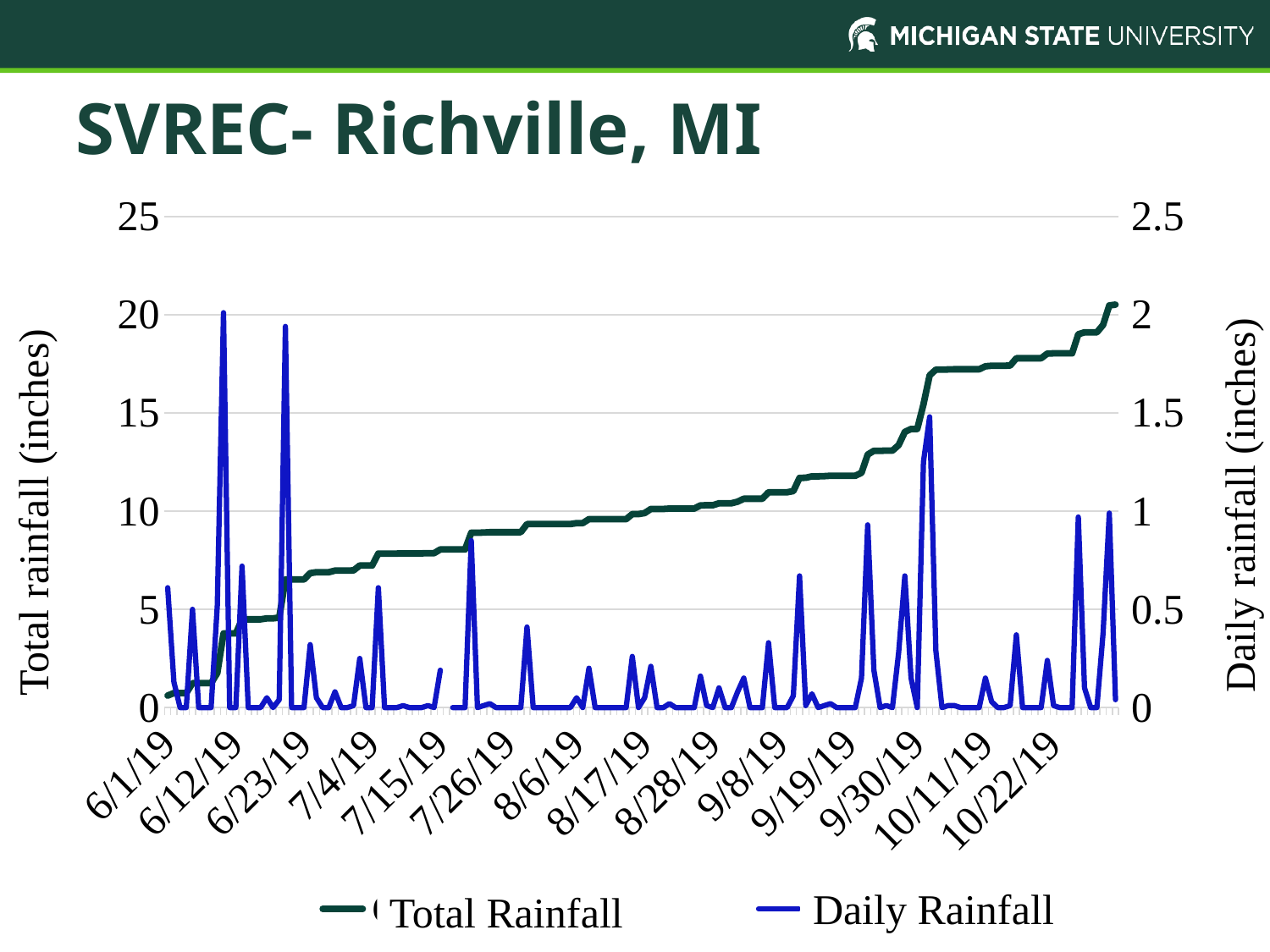
Is the Total Rainfall value at 7/4/19 greater or less than 10 inches? less Is the Daily Rainfall spike near 9/30/19 greater or less than 1 inch? greater How many series does the legend list? 2 Is the Total Rainfall value at 6/1/19 greater or less than 5 inches? less Does the Total Rainfall series rise or fall from 6/1/19 to 10/22/19? rises What kind of chart is shown on the slide? line chart What is the title of the slide's chart? SVREC- Richville, MI Which series is drawn in blue according to the legend? Daily Rainfall How many date labels are shown along the x axis? 14